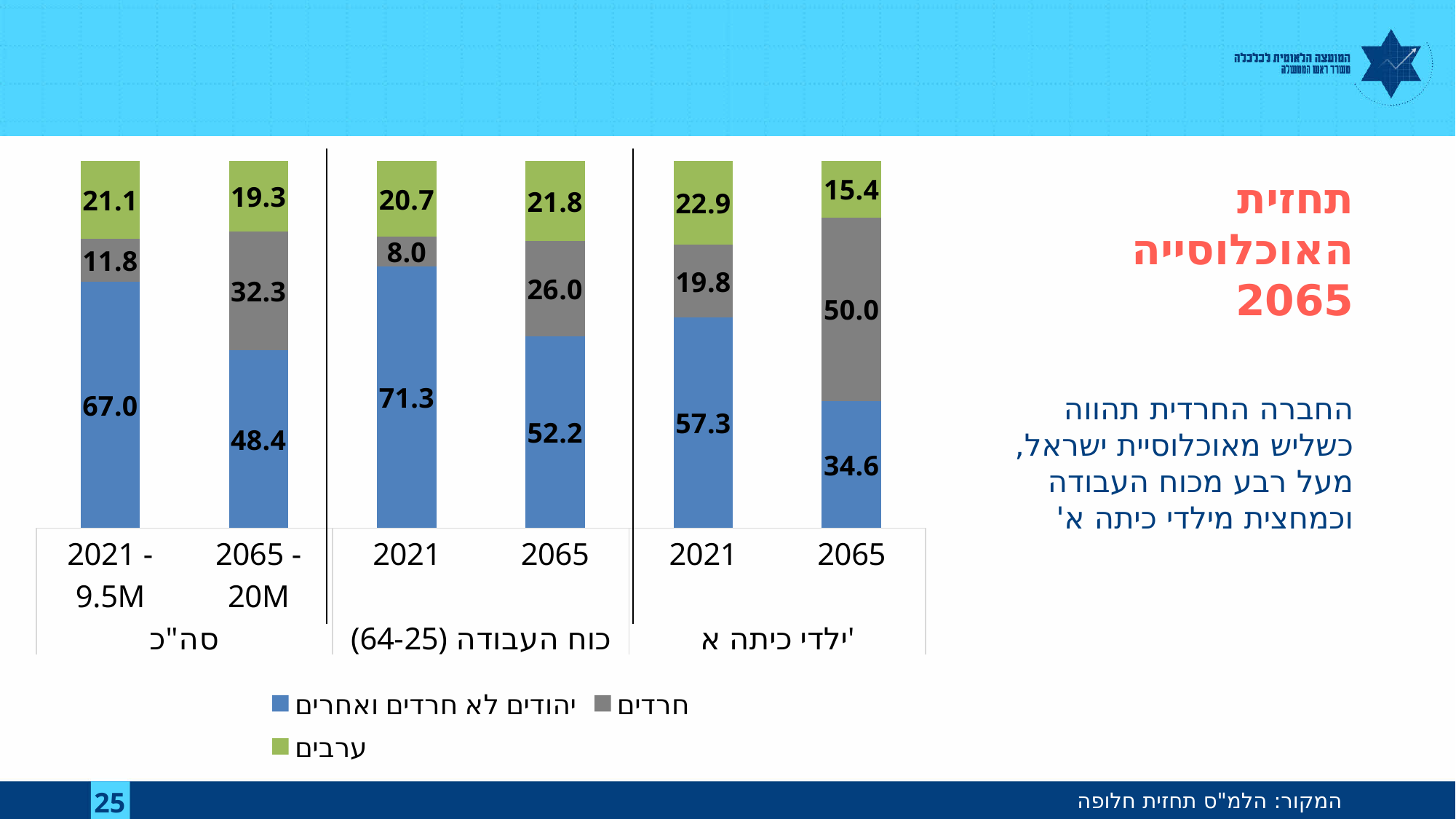
What is the difference between the חרדים values for סה"כ 2065 - 20M and סה"כ 2021 - 9.5M? 20.5 Which bar has the highest value for חרדים? ילדי כיתה א 2065 Which is larger: the ערבים value for ילדי כיתה א 2021 or for ילדי כיתה א 2065? ילדי כיתה א 2021 What kind of chart is shown on the slide? Stacked bar chart What is the value for ערבים in the כוח העבודה (64-25) 2065 bar? 21.8 What is the value for חרדים in the ילדי כיתה א 2065 bar? 50.0 What is the value for חרדים in the כוח העבודה (64-25) 2021 bar? 8.0 Which bar has the lowest value for יהודים לא חרדים ואחרים? ילדי כיתה א 2065 What is the value for יהודים לא חרדים ואחרים in the סה"כ 2021 - 9.5M bar? 67.0 How many series does the legend list? 3 What is the title of the chart on the slide? תחזית האוכלוסייה 2065 How many stacked bars are shown in the chart? 6